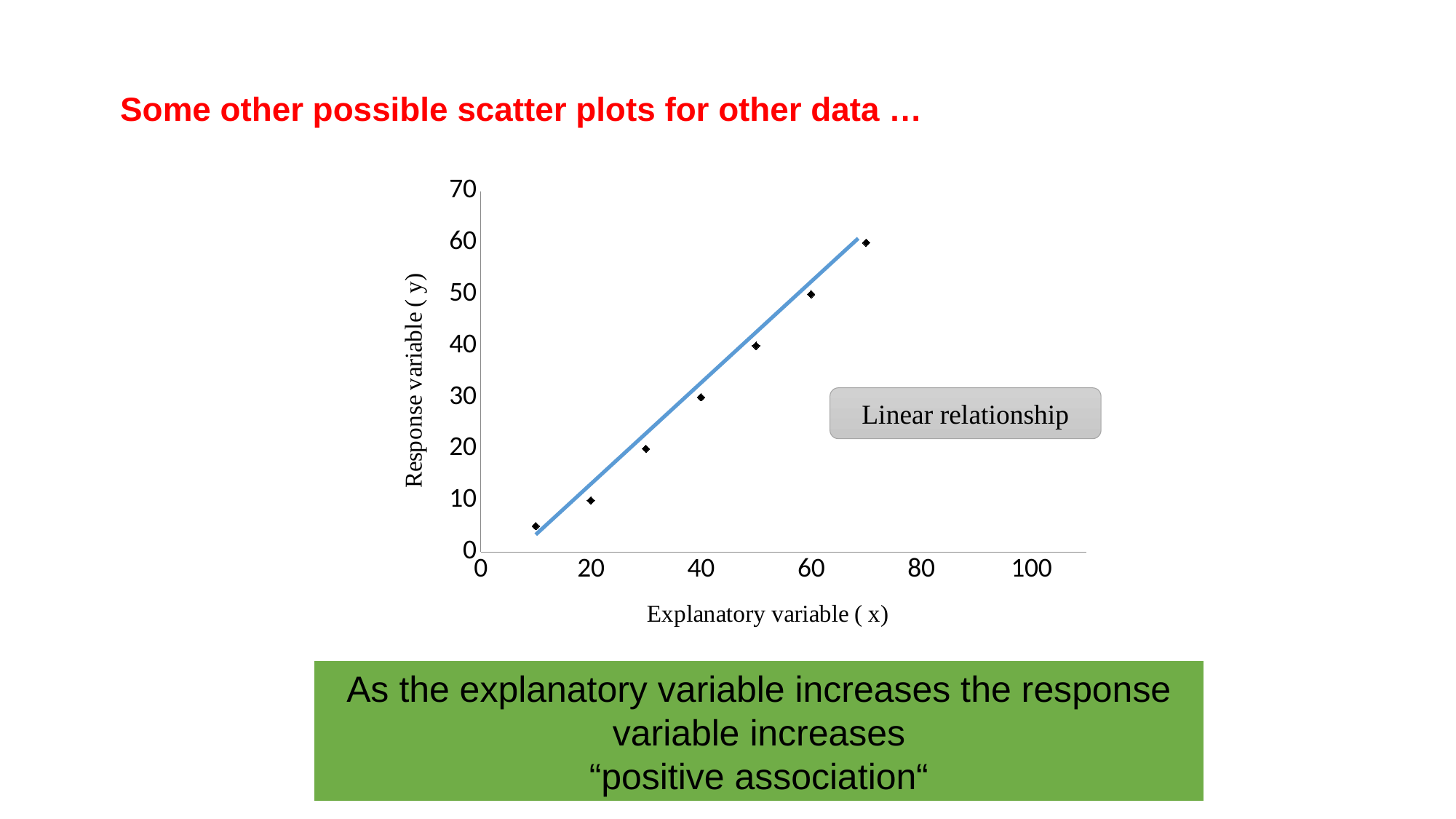
Do the plotted values rise or fall as the explanatory variable increases? rise What is the label of the x axis? Explanatory variable ( x) How many data points are plotted on the scatter plot? 7 What is the label of the y axis? Response variable ( y) Is the response value for the point at x = 20 greater or less than 20? less Is the response value for the point at x = 10 greater or less than 10? less Is the response value for the point at x = 40 greater or less than 20? greater What kind of chart is shown on the slide? scatter plot Which point has the highest response value, the one at x = 10 or the one at x = 70? x = 70 At which x value does the point with the lowest response value occur? 10 At which x value does the point with the highest response value occur? 70